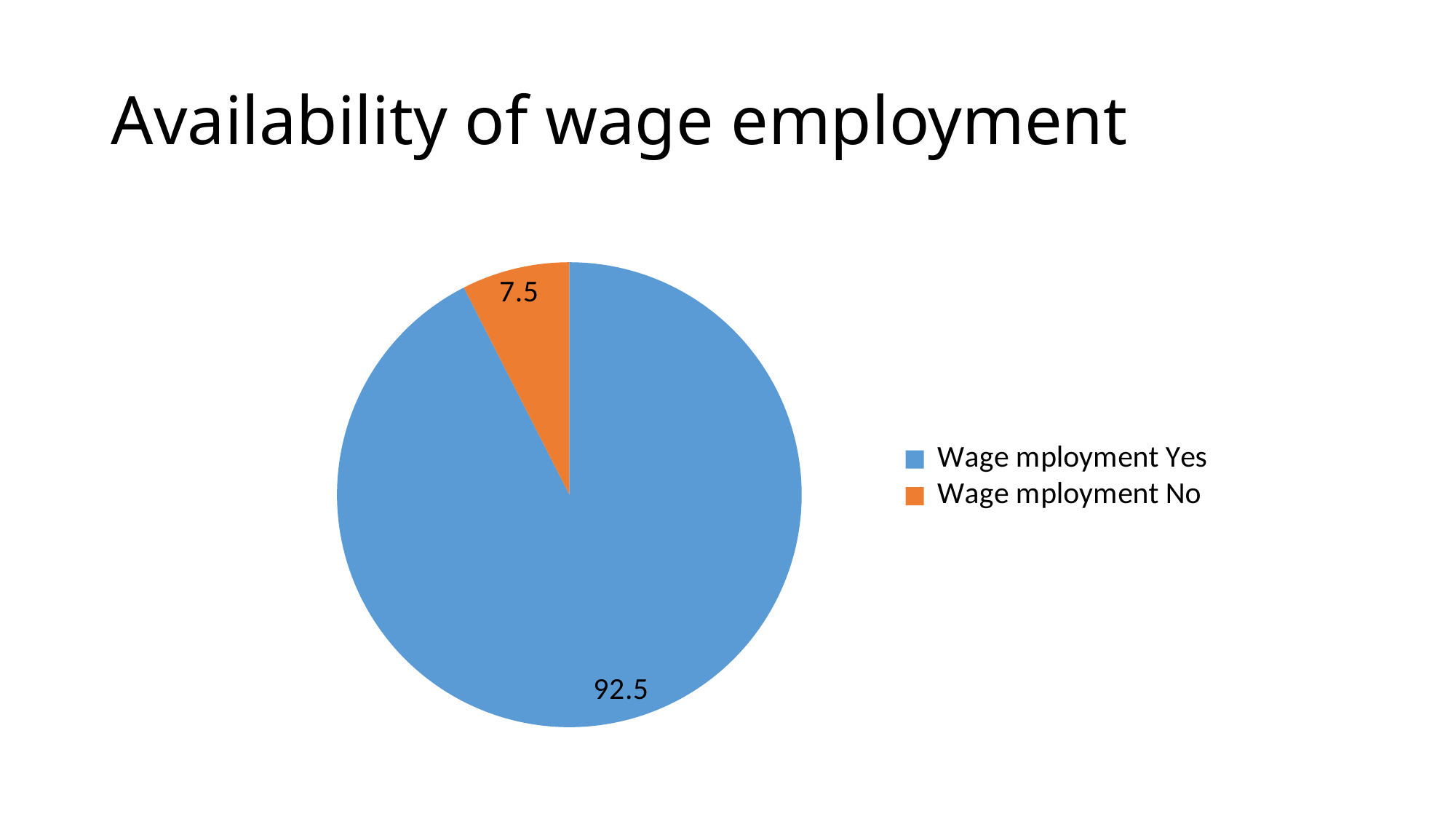
What is the title of the slide containing the chart? Availability of wage employment What type of chart is shown on the slide? Pie chart How many slices does the pie chart have? 2 What colour is the slice for Wage mployment No? Orange How many entries does the legend list? 2 Which category has the largest slice of the pie? Wage mployment Yes What is the value for Wage mployment Yes? 92.5 What is the difference between the values for Wage mployment Yes and Wage mployment No? 85 Which is larger, the value for Wage mployment Yes or Wage mployment No? Wage mployment Yes What is the total of the two slice values shown on the pie chart? 100 Which category has the smallest slice of the pie? Wage mployment No What is the value for Wage mployment No? 7.5